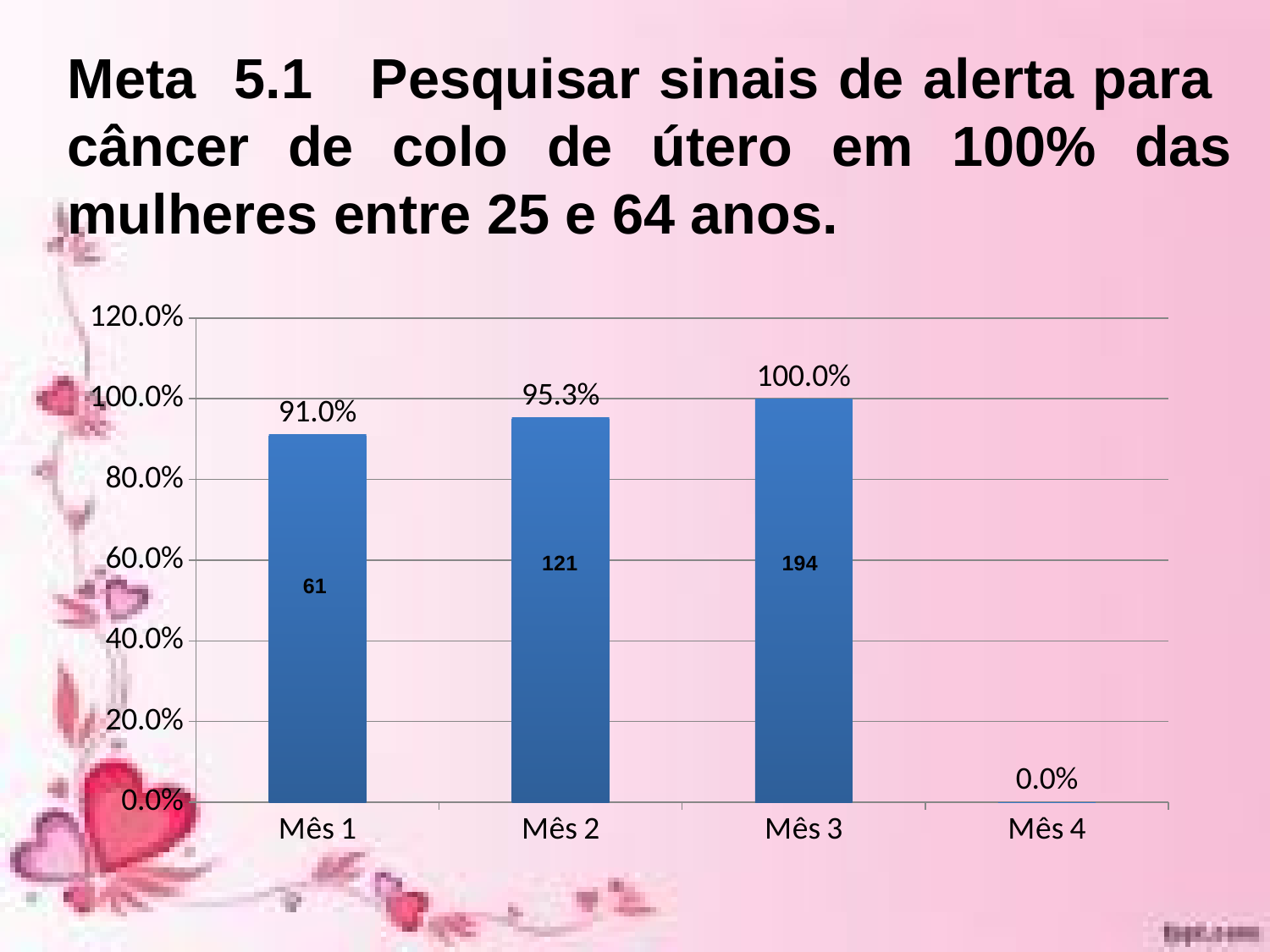
What is the difference in percentage points between Mês 3 and Mês 1? 9.0% Do the percentage values rise or fall from Mês 1 to Mês 3? Rise What number is printed inside the bar for Mês 3? 194 What kind of chart is shown on the slide? Bar chart Which has a higher percentage value, Mês 1 or Mês 2? Mês 2 Which month has the lowest percentage value? Mês 4 How many months (categories) are shown on the x axis? 4 What number is printed inside the bar for Mês 1? 61 What is the percentage value shown for Mês 4? 0.0% What is the percentage value shown for Mês 2? 95.3% Which month has the highest percentage value? Mês 3 What is the percentage value shown for Mês 1? 91.0%